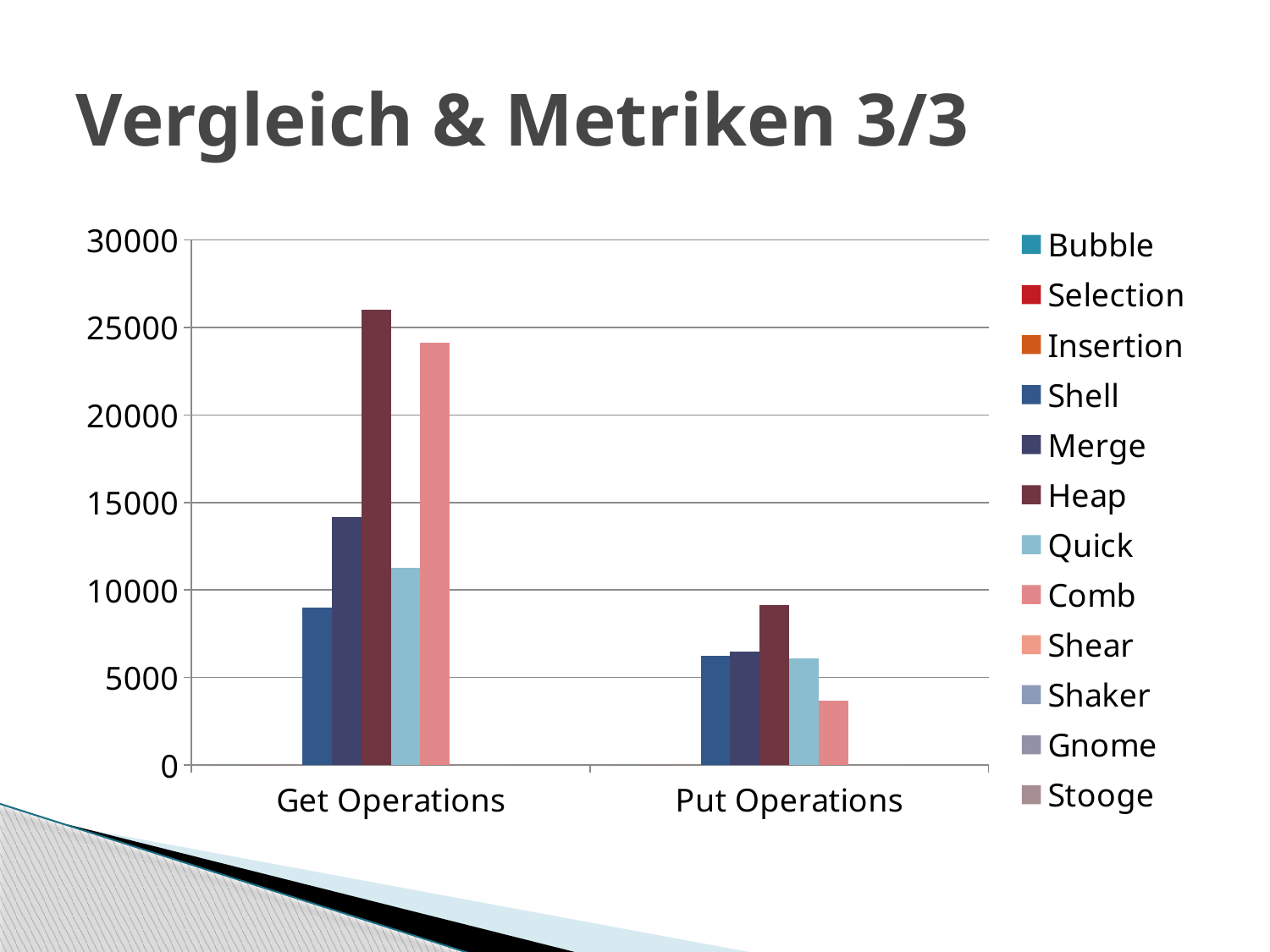
Which series has the highest value for Put Operations? Heap What is the title of the slide? Vergleich & Metriken 3/3 For Get Operations, which is larger: Merge or Shell? Merge How many series does the legend list? 12 What kind of chart is shown on the slide? bar chart How many categories are shown on the x axis? 2 Is the value for Shell in Get Operations greater or less than 10000? less Which series has the highest value for Get Operations? Heap Is the value for Heap in Put Operations greater or less than 10000? less Does the value for Heap rise or fall from Get Operations to Put Operations? fall Is the value for Heap in Get Operations greater or less than 25000? greater